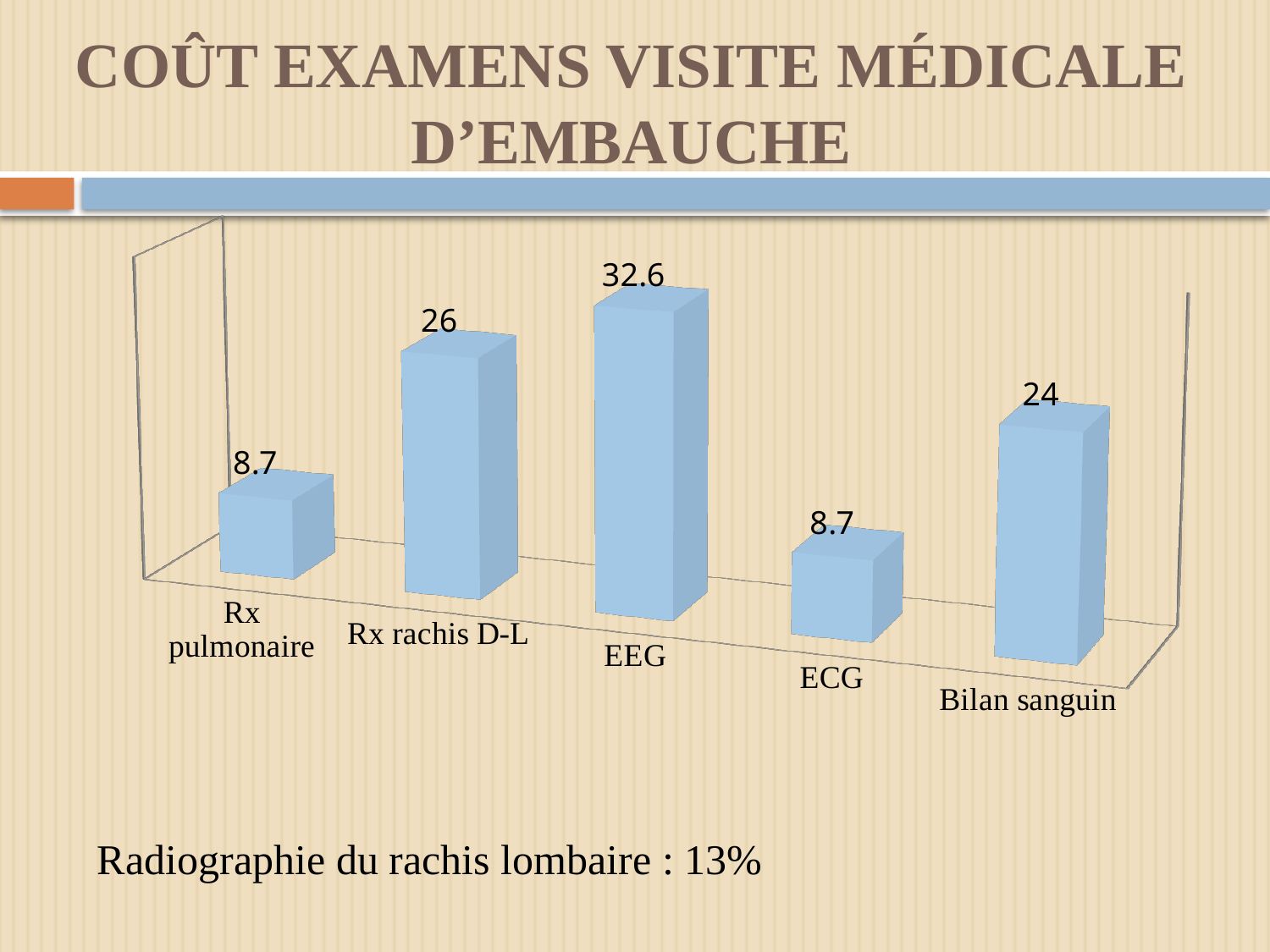
What is the difference between the values for Rx rachis D-L and Bilan sanguin? 2 What is the difference between the values for EEG and Rx rachis D-L? 6.6 What is the value for EEG? 32.6 How many categories are shown in the chart? 5 What kind of chart is shown on the slide? bar chart Which two categories share the same value of 8.7? Rx pulmonaire and ECG What is the value for ECG? 8.7 What is the value for Rx rachis D-L? 26 What is the value for Bilan sanguin? 24 What is the title of the slide containing the chart? COÛT EXAMENS VISITE MÉDICALE D'EMBAUCHE Which category has the highest value? EEG Which is larger, the value for Bilan sanguin or the value for ECG? Bilan sanguin